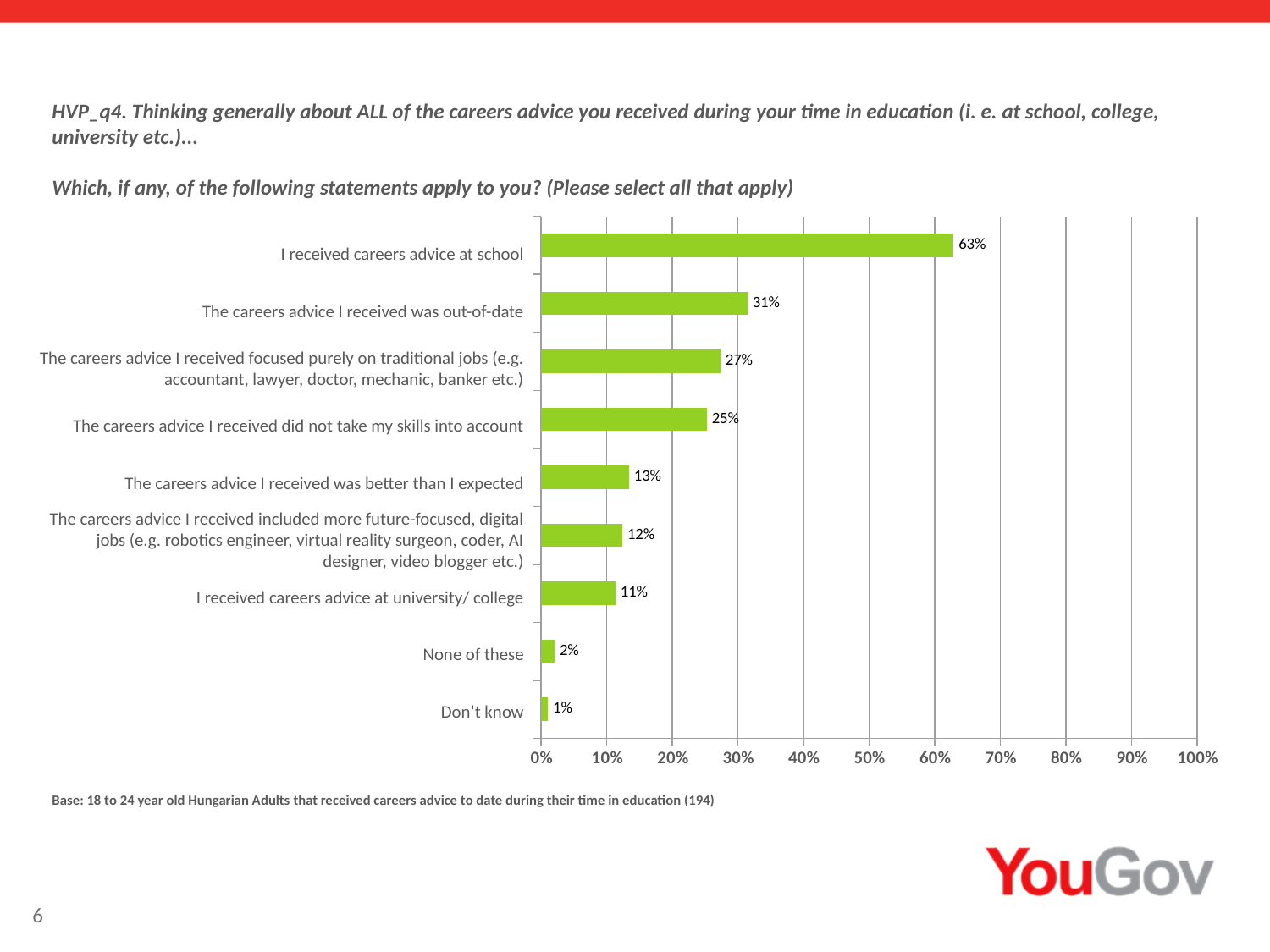
What kind of chart is shown on the slide? Bar chart Which category has the lowest percentage? Don't know Which statement has the highest percentage? I received careers advice at school How many categories are shown in the chart? 9 What is the highest value shown on the x axis? 100% What is the difference between the percentage saying the advice was better than expected and the percentage saying it included more future-focused, digital jobs? 1% What is the difference between the percentage who received careers advice at school and the percentage who received it at university/ college? 52% What percentage answered 'Don't know'? 1% Which is larger: the percentage saying the advice focused purely on traditional jobs, or the percentage saying it did not take their skills into account? The careers advice I received focused purely on traditional jobs What percentage said the careers advice they received was out-of-date? 31% What percentage of respondents said they received careers advice at school? 63% What percentage said they received careers advice at university/ college? 11%